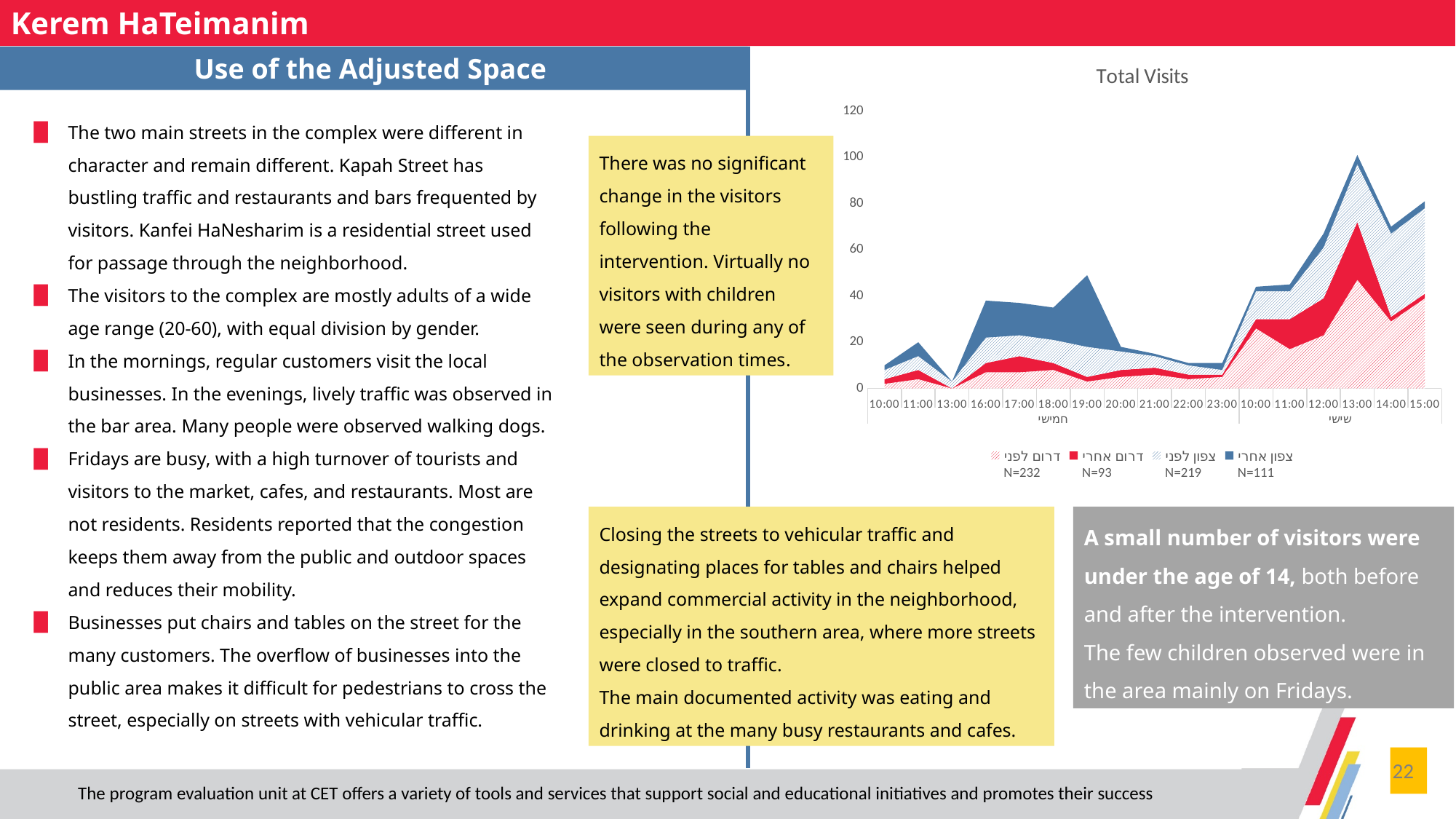
In the "Total Visits" chart, is the stacked total at 19:00 on חמישי greater or less than 40? greater How many series does the legend of the "Total Visits" chart list? 4 In the "Total Visits" chart, is the stacked total at 15:00 on שישי greater or less than 60? greater In the "Total Visits" chart, is the stacked total at 13:00 on שישי greater or less than 80? greater What is the highest value shown on the y axis of the "Total Visits" chart? 120 How many time points are shown along the x axis of the "Total Visits" chart? 17 In the "Total Visits" chart, which is larger: the stacked total at 13:00 on שישי or at 18:00 on חמישי? 13:00 on שישי In the "Total Visits" chart, does the stacked total rise or fall from 10:00 to 13:00 on שישי? rise What kind of chart is the "Total Visits" chart? area chart In the "Total Visits" chart, at which time point does the stacked total reach its highest value? 13:00 (שישי) What is the title of the chart on the slide? Total Visits